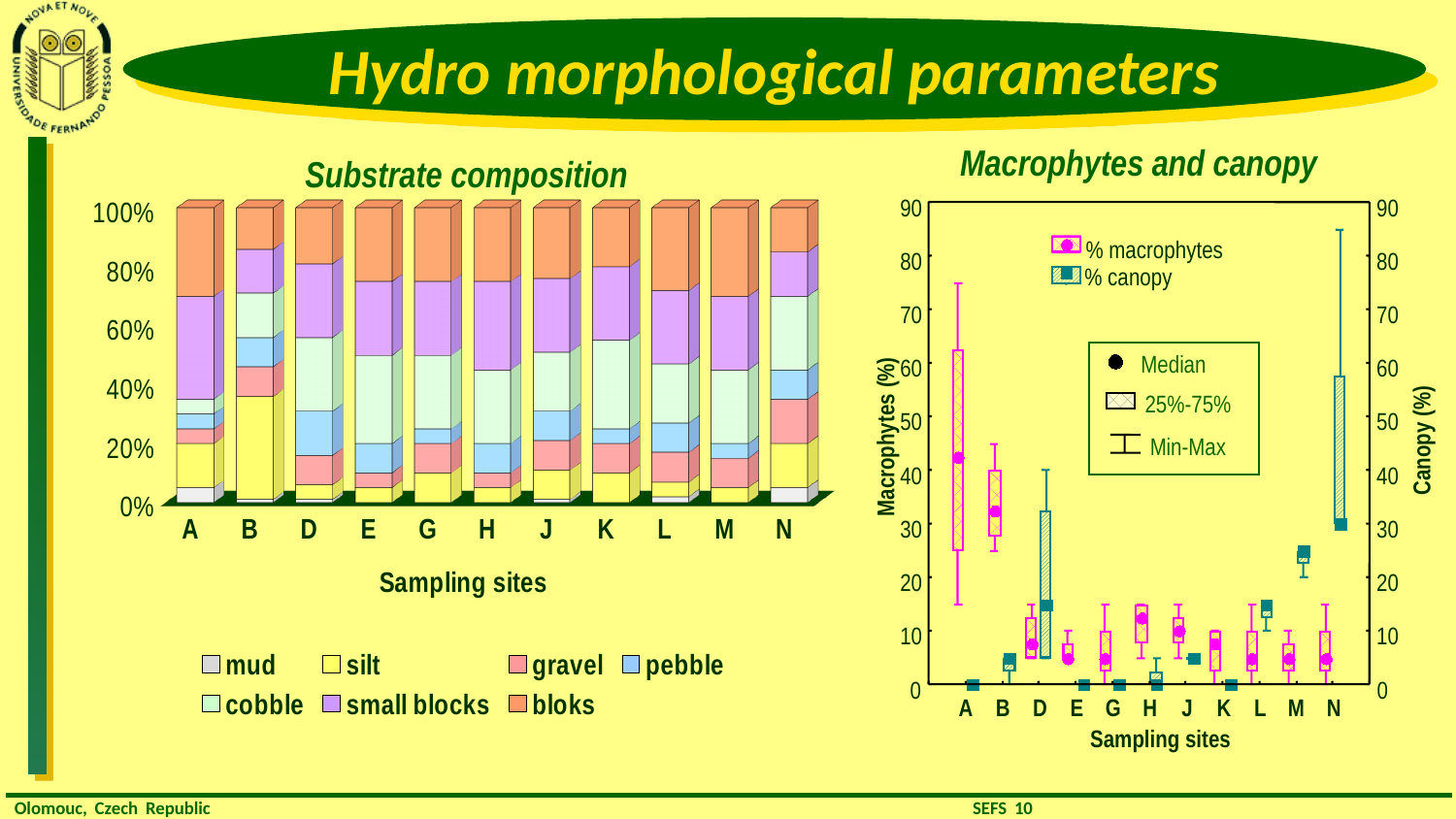
How many series does the legend of the Macrophytes and canopy chart list? 2 In the Substrate composition chart, is the silt share larger for site A or site B? B How many substrate types does the legend of the Substrate composition chart list? 7 What kind of chart is the Substrate composition chart? Stacked bar chart In the Substrate composition chart, is the silt share for site B greater or less than 20%? greater In the Macrophytes and canopy chart, which site has the highest median % canopy? N How many sampling sites are shown on the x axis of the Macrophytes and canopy chart? 11 In the Substrate composition chart, is the cobble share for site E greater or less than 20%? greater How many sampling sites are shown on the x axis of the Substrate composition chart? 11 What is the label of the right-hand y axis of the Macrophytes and canopy chart? Canopy (%) In the Macrophytes and canopy chart, is the median % macrophytes for site A greater or less than 30? greater In the Macrophytes and canopy chart, which site has the highest median % macrophytes? A